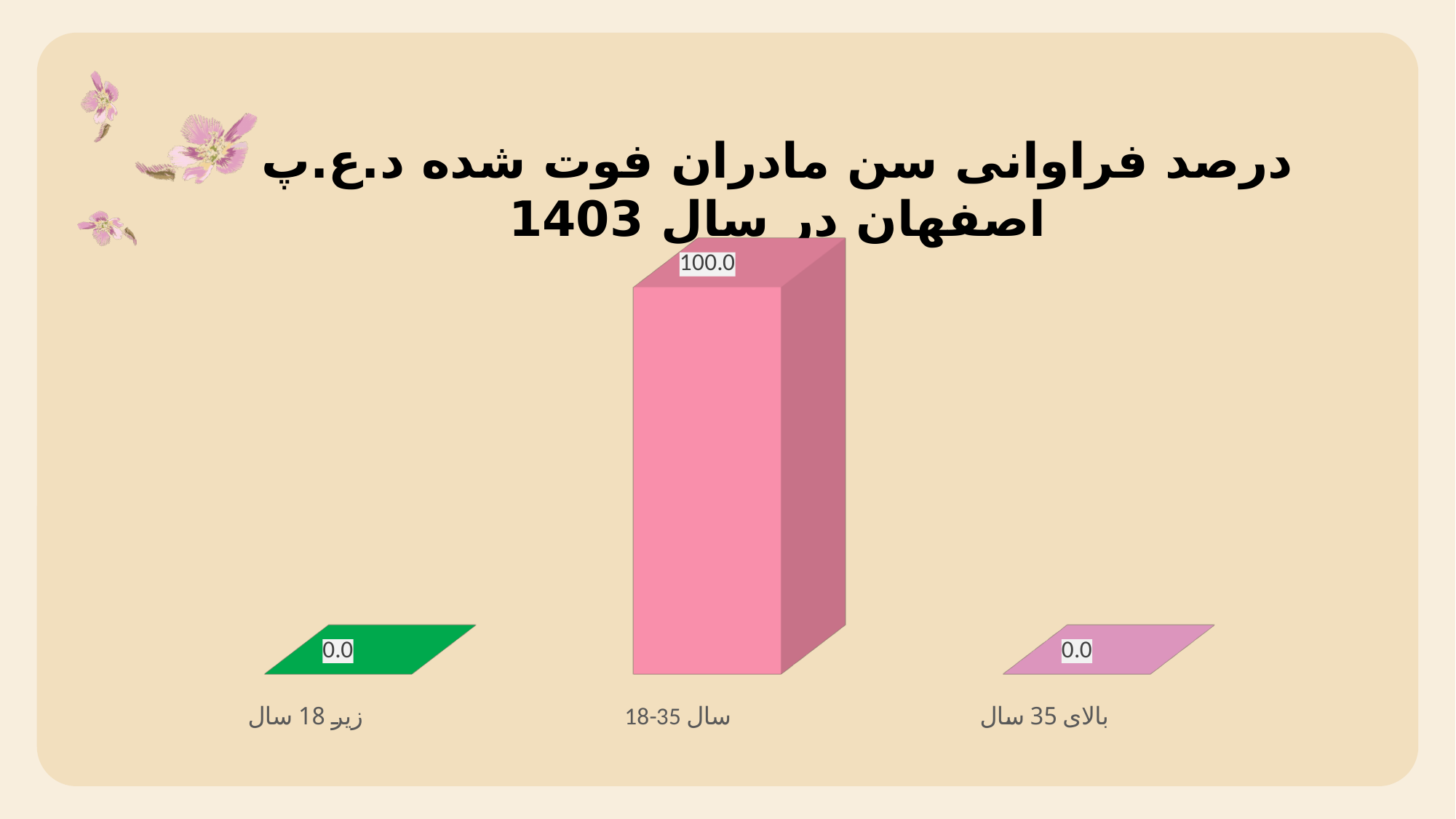
How many categories on the chart have a value of 0.0? 2 What colour is the bar for "زیر 18 سال"? Green Which category has the highest value? 18-35 سال Which is larger, the value for "18-35 سال" or the value for "زیر 18 سال"? 18-35 سال What is the value shown for the category "بالای 35 سال"? 0.0 How many categories are shown on the chart? 3 What kind of chart is shown on the slide? Bar chart What is the value shown for the category "زیر 18 سال"? 0.0 What is the value shown for the category "18-35 سال"? 100.0 What is the total of the three values shown on the chart? 100.0 What is the difference between the values for "18-35 سال" and "بالای 35 سال"? 100.0 What colour is the bar for "18-35 سال"? Pink